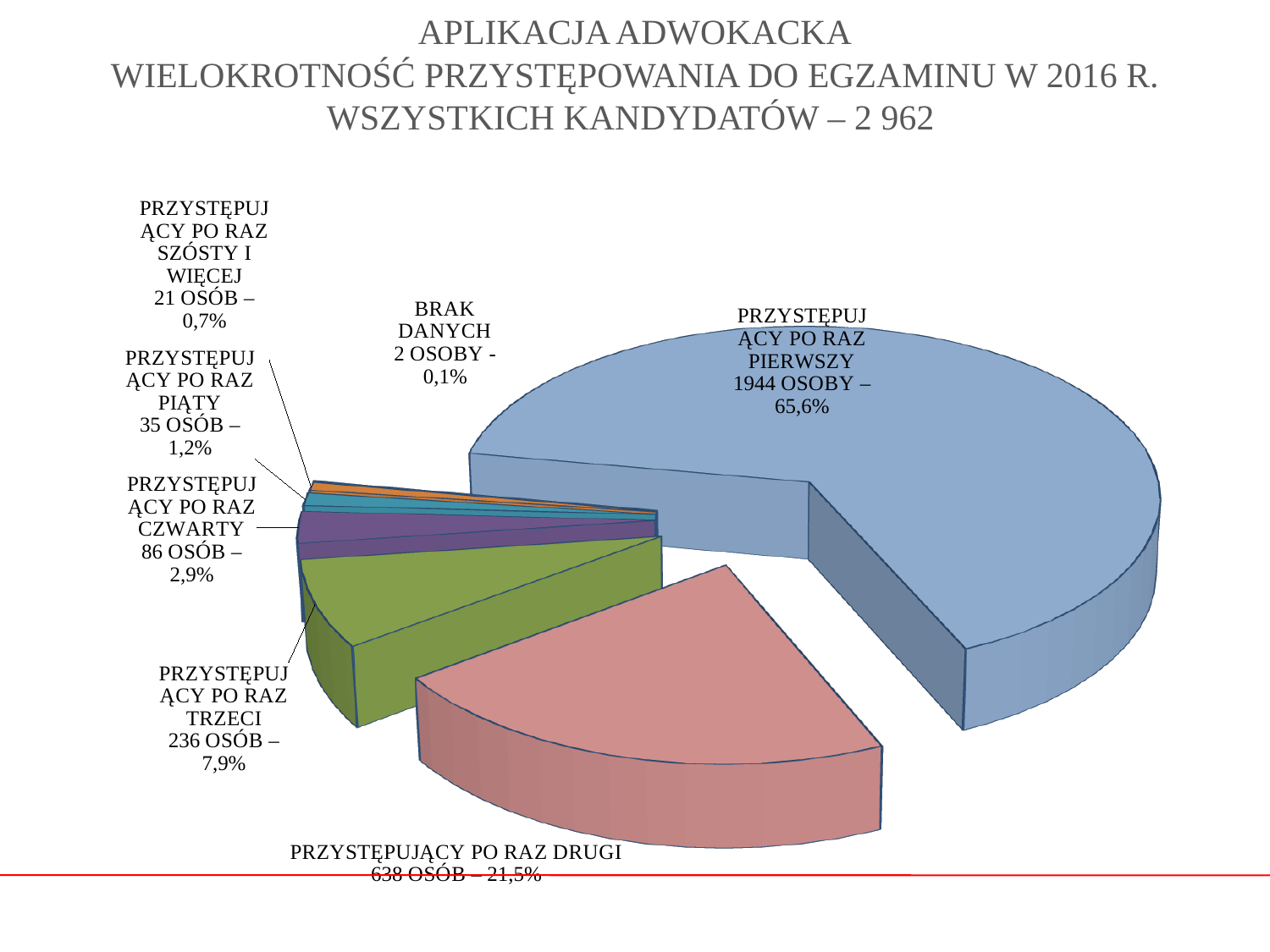
Which is larger, PRZYSTĘPUJĄCY PO RAZ CZWARTY or PRZYSTĘPUJĄCY PO RAZ PIĄTY? PRZYSTĘPUJĄCY PO RAZ CZWARTY How many slices does the pie chart have? 7 What percentage is shown for PRZYSTĘPUJĄCY PO RAZ TRZECI? 7,9% What is the difference in number of people between PRZYSTĘPUJĄCY PO RAZ PIERWSZY and PRZYSTĘPUJĄCY PO RAZ DRUGI? 1306 What total number of candidates is given in the chart title? 2 962 Which slice is the largest? PRZYSTĘPUJĄCY PO RAZ PIERWSZY What share of the pie is PRZYSTĘPUJĄCY PO RAZ PIERWSZY? 65,6% How many people took the exam for the first time (PRZYSTĘPUJĄCY PO RAZ PIERWSZY)? 1944 OSOBY How many people are in the BRAK DANYCH slice? 2 OSOBY Which slice is the smallest? BRAK DANYCH How many people are in the PRZYSTĘPUJĄCY PO RAZ DRUGI slice? 638 OSÓB What kind of chart is shown on the slide? pie chart